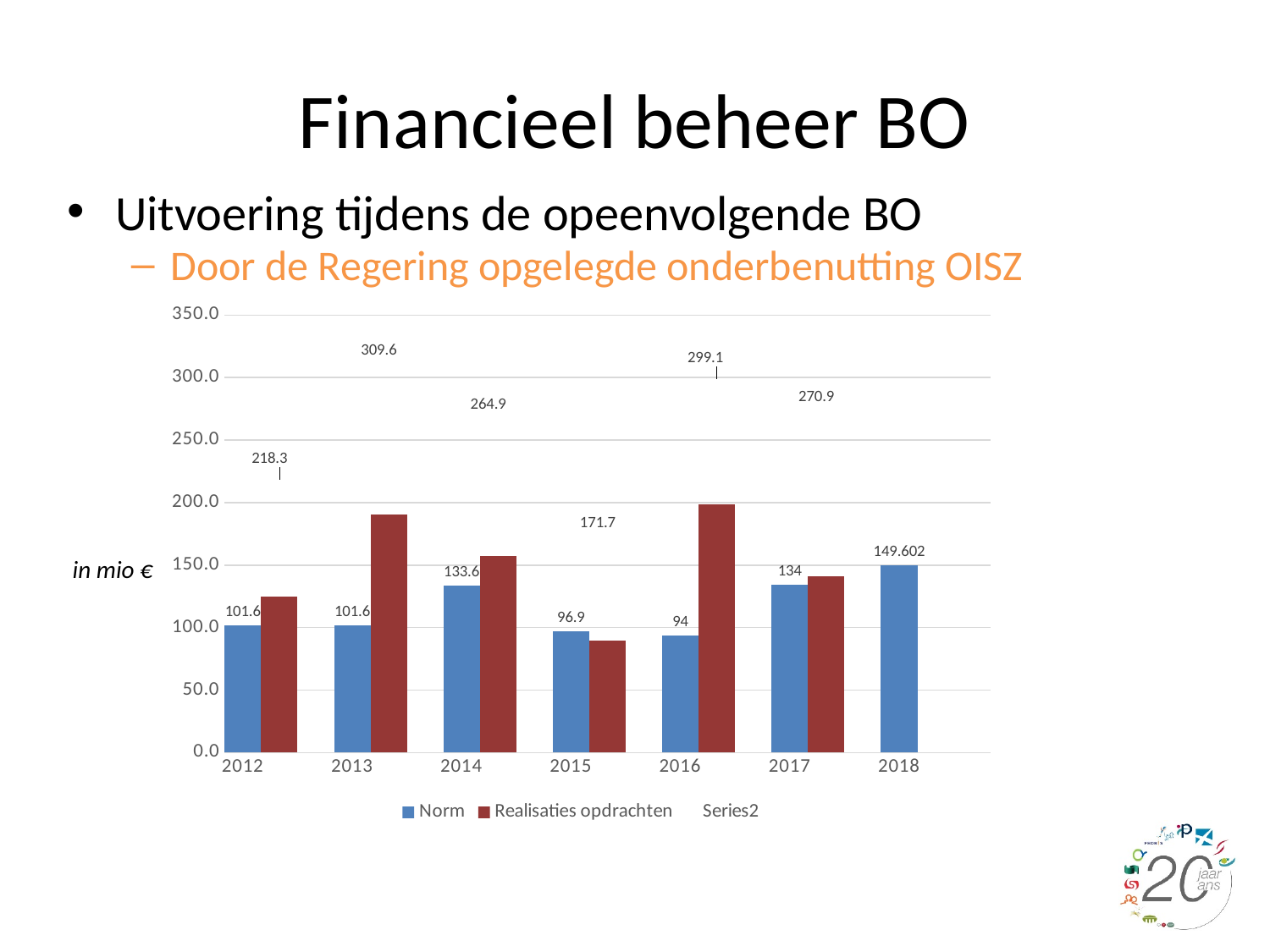
What is the Norm value for 2018? 149.602 How many years are shown on the x axis of the chart? 7 What is the Norm value for 2016? 94 Which year has the highest Norm value? 2018 What is the difference between the Norm values for 2017 and 2012? 32.4 Is the Realisaties opdrachten value for 2016 greater or less than 150.0? greater Which year has the larger Norm value, 2014 or 2017? 2017 What is the Norm value for 2014? 133.6 What kind of chart is shown on the slide? bar chart Is the Realisaties opdrachten value for 2015 greater or less than 100.0? less Which year has the lowest Norm value? 2016 How many series does the chart legend list? 3